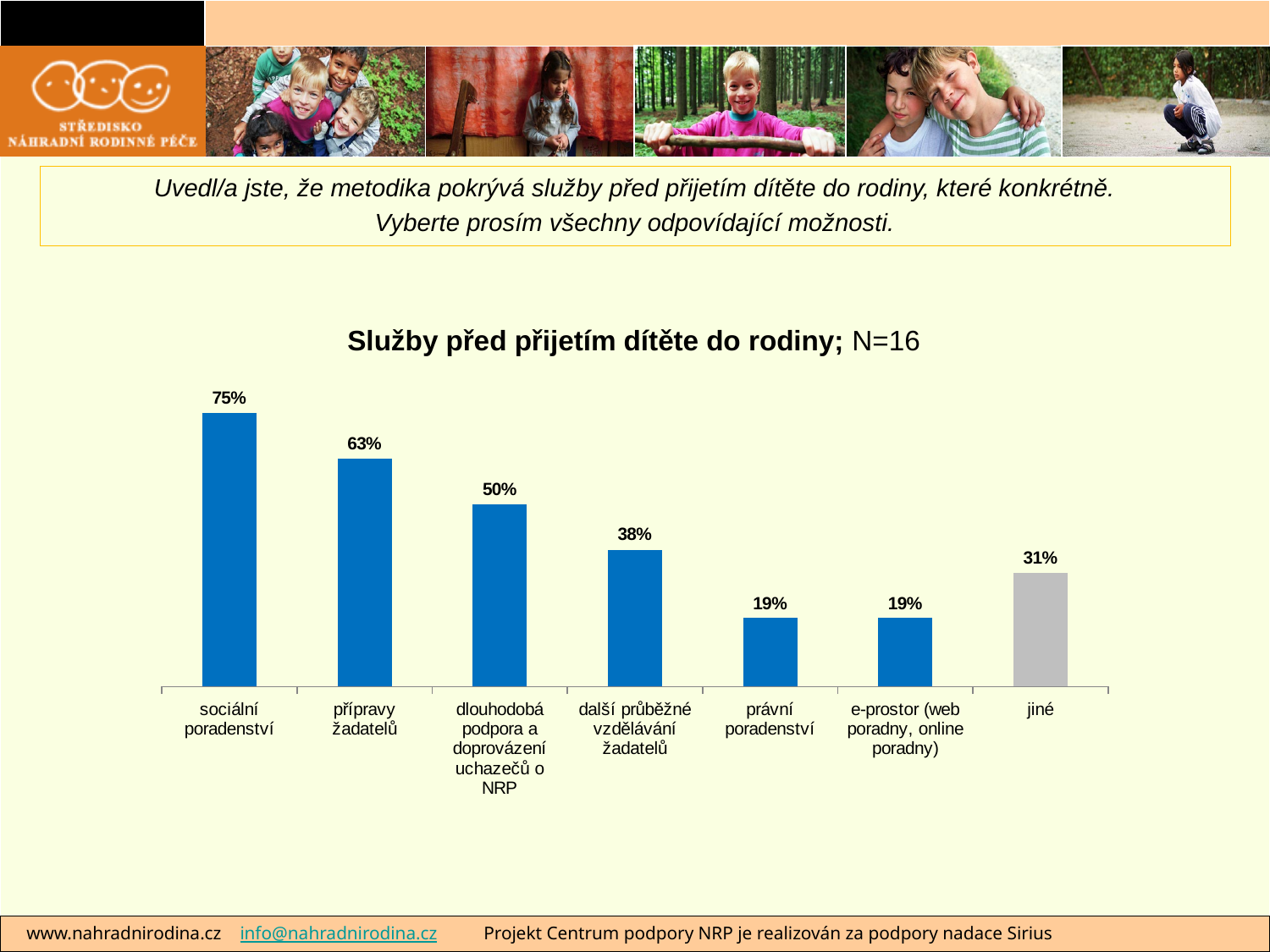
What kind of chart is shown? bar chart What is the N value stated in the chart title? 16 What is the difference between 'sociální poradenství' and 'přípravy žadatelů'? 12% What is the difference between 'dlouhodobá podpora a doprovázení uchazečů o NRP' and 'právní poradenství'? 31% How many categories are shown in the chart? 7 What is the value for 'přípravy žadatelů'? 63% What is the value for 'další průběžné vzdělávání žadatelů'? 38% What is the value for 'jiné'? 31% What is the value for 'sociální poradenství'? 75% Which category has the highest value? sociální poradenství Which bar is coloured grey rather than blue? jiné Which is larger, 'jiné' or 'e-prostor (web poradny, online poradny)'? jiné